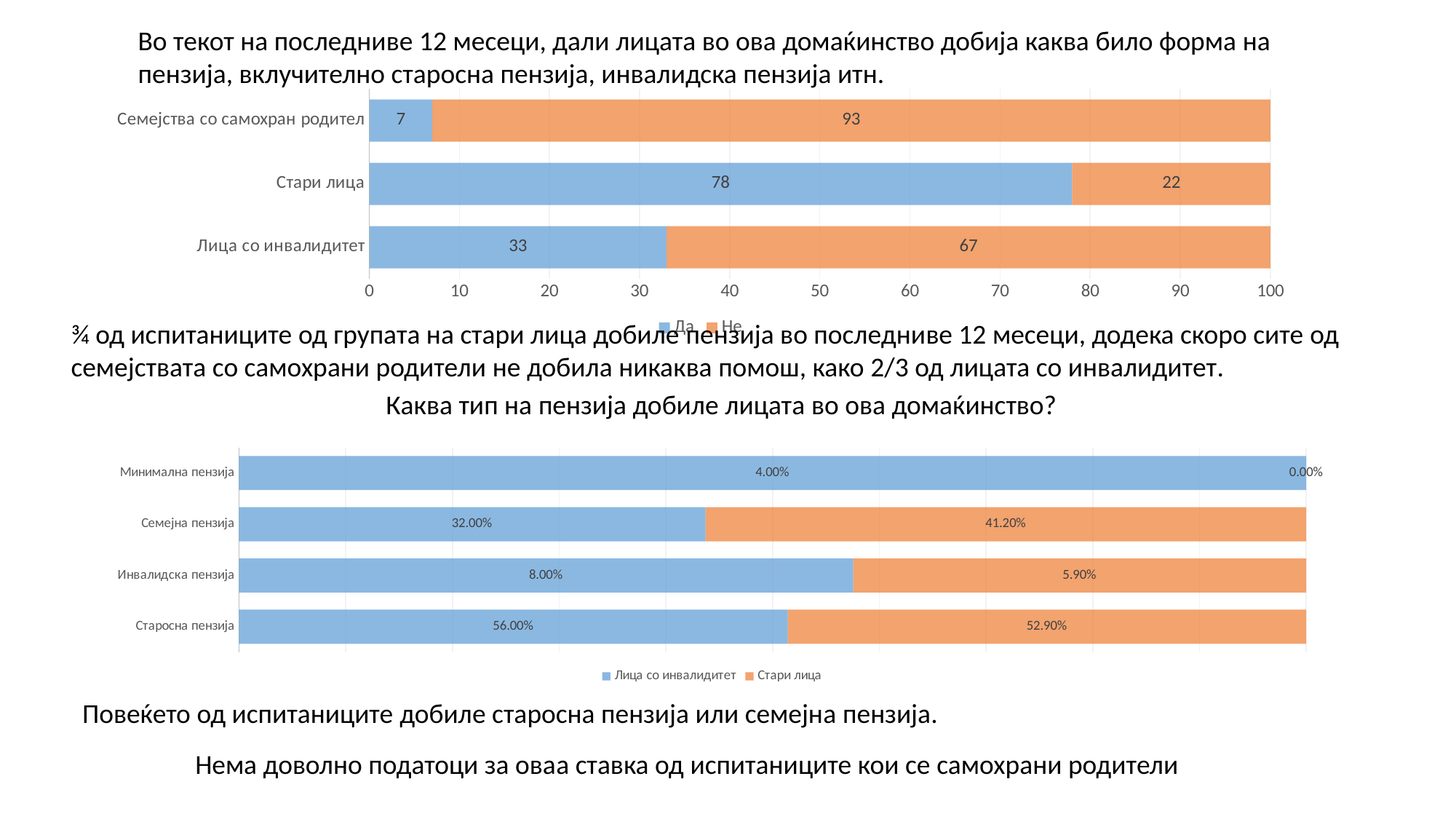
In the top chart, what is the total of the stacked bar for Лица со инвалидитет? 100 What kind of chart is the bottom chart? Stacked bar chart In the top chart, what is the value for "Не" for Семејства со самохран родител? 93 In the top chart, what is the value for "Да" for Стари лица? 78 In the top chart, what is the difference between the "Не" values for Лица со инвалидитет and Стари лица? 45 In the bottom chart ("Каква тип на пензија добиле лицата во ова домаќинство?"), what is the value for Стари лица for Семејна пензија? 41.20% In the bottom chart, what is the value for Лица со инвалидитет for Старосна пензија? 56.00% In the top chart, how many categories are shown? 3 In the top chart, which category has the lowest value for "Не"? Стари лица In the bottom chart, how many series does the legend list? 2 In the top chart, which category has the highest value for "Да"? Стари лица In the bottom chart, which category has the highest value for Стари лица? Старосна пензија